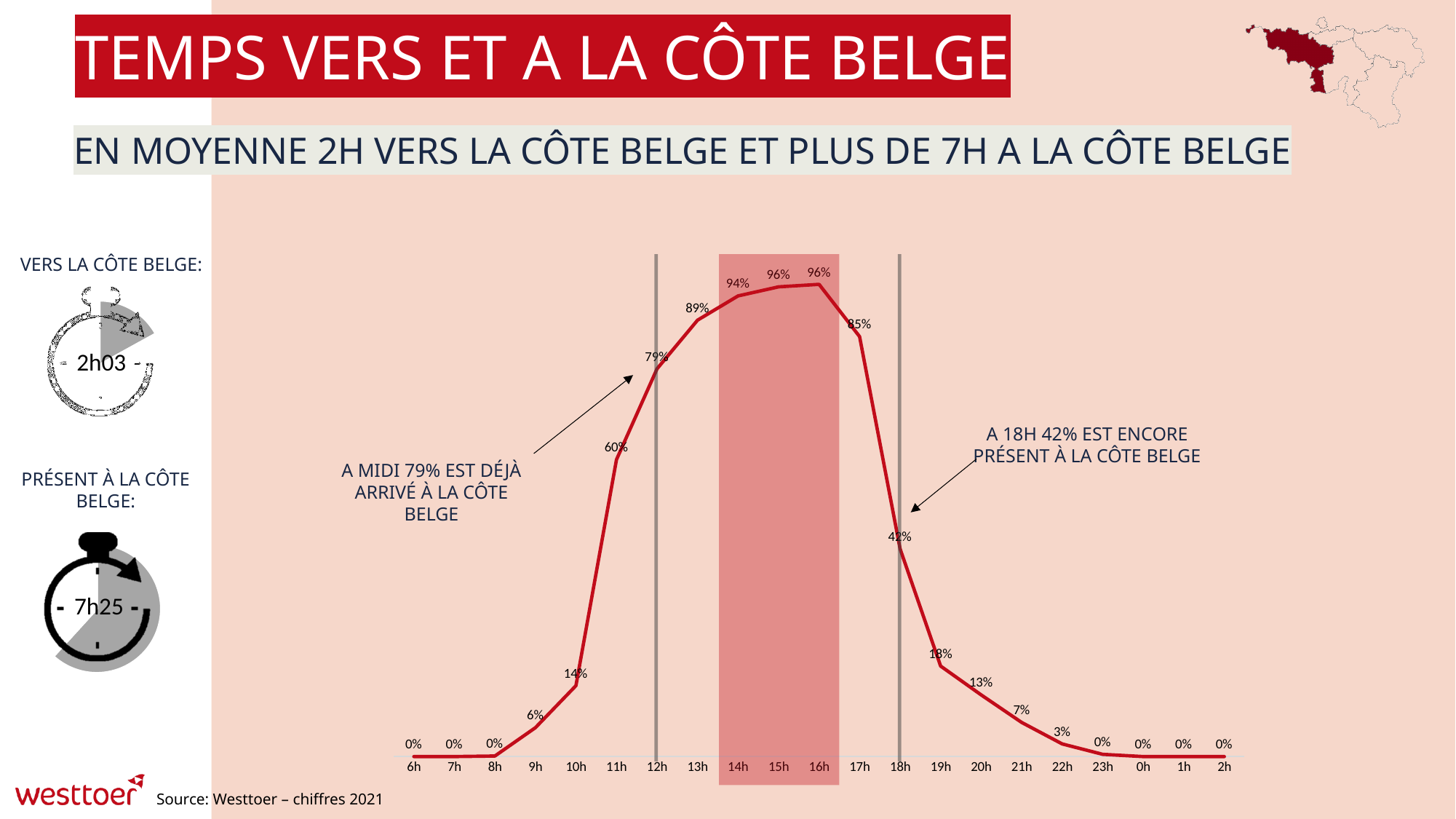
What is the difference between the values at 13h and 12h? 10% Which is larger, the value at 10h or the value at 19h? 19h What is the difference between the values at 17h and 18h? 43% What is the value at 20h? 13% What is the highest value plotted on the chart? 96% What is the value at 11h? 60% Do the values rise or fall between 16h and 22h? fall What kind of chart is shown on the slide? line chart Which hours are covered by the shaded red band on the chart? 14h, 15h and 16h What is the value at 18h? 42% What is the value at 12h? 79% How many hourly points are plotted on the x axis? 21